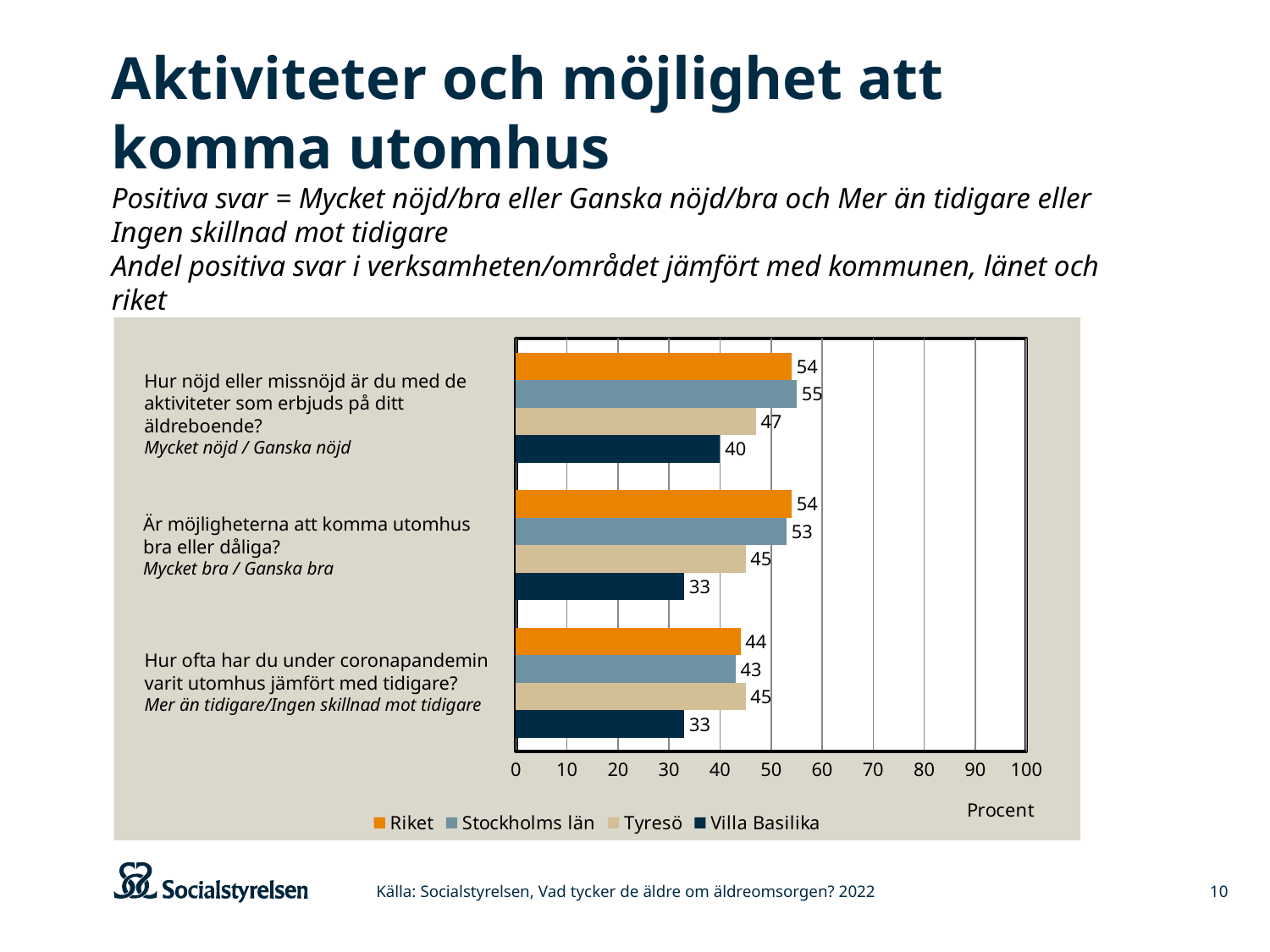
How many series does the legend list? 4 What is the value for Tyresö on the question 'Är möjligheterna att komma utomhus bra eller dåliga?' 45 What is the difference between Riket and Villa Basilika on the question 'Är möjligheterna att komma utomhus bra eller dåliga?' 21 What type of chart is shown on the slide? Bar chart Which series has the lowest value on the question 'Är möjligheterna att komma utomhus bra eller dåliga?' Villa Basilika Is the value for Riket on the question 'Hur nöjd eller missnöjd är du med de aktiviteter som erbjuds på ditt äldreboende?' greater or less than 50? greater How many question categories are plotted on the chart? 3 Which is larger on the question 'Hur ofta har du under coronapandemin varit utomhus jämfört med tidigare?': Tyresö or Villa Basilika? Tyresö What is the value for Villa Basilika on the question 'Hur nöjd eller missnöjd är du med de aktiviteter som erbjuds på ditt äldreboende?' 40 What unit label is shown below the x axis of the chart? Procent What is the value for Stockholms län on the question 'Hur ofta har du under coronapandemin varit utomhus jämfört med tidigare?' 43 Which series has the highest value on the question 'Hur nöjd eller missnöjd är du med de aktiviteter som erbjuds på ditt äldreboende?' Stockholms län